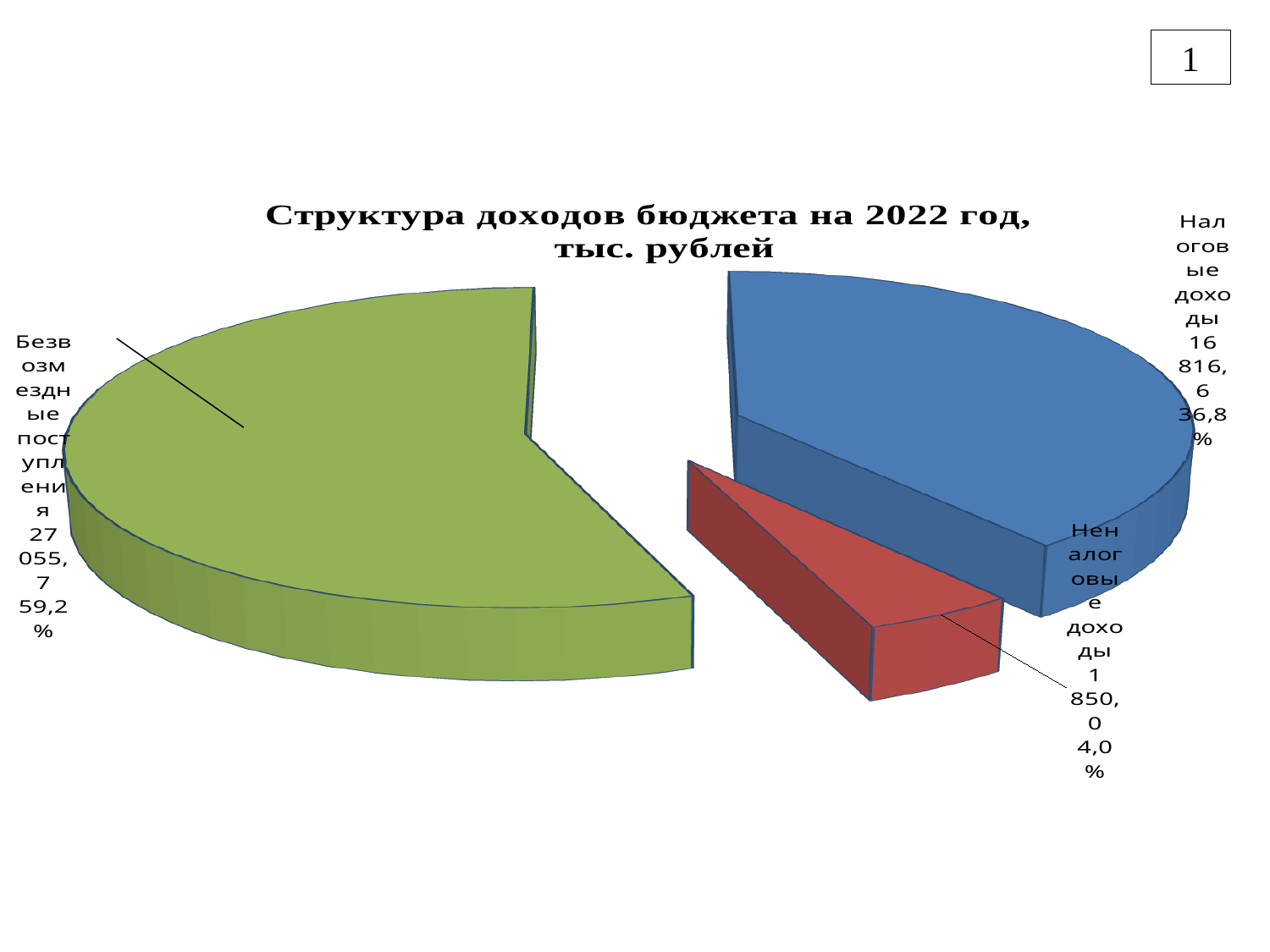
What is the title of the chart? Структура доходов бюджета на 2022 год, тыс. рублей What share of the pie does Налоговые доходы represent? 36,8% What is the value for Налоговые доходы? 16 816,6 How many slices does the pie chart have? 3 Which is larger, Налоговые доходы or Неналоговые доходы? Налоговые доходы What share of the pie does Неналоговые доходы represent? 4,0% Which category has the smallest slice? Неналоговые доходы What share of the pie does Безвозмездные поступления represent? 59,2% Which category has the largest slice? Безвозмездные поступления What kind of chart is shown on the slide? Pie chart What is the value for Неналоговые доходы? 1 850,0 What is the value for Безвозмездные поступления? 27 055,7